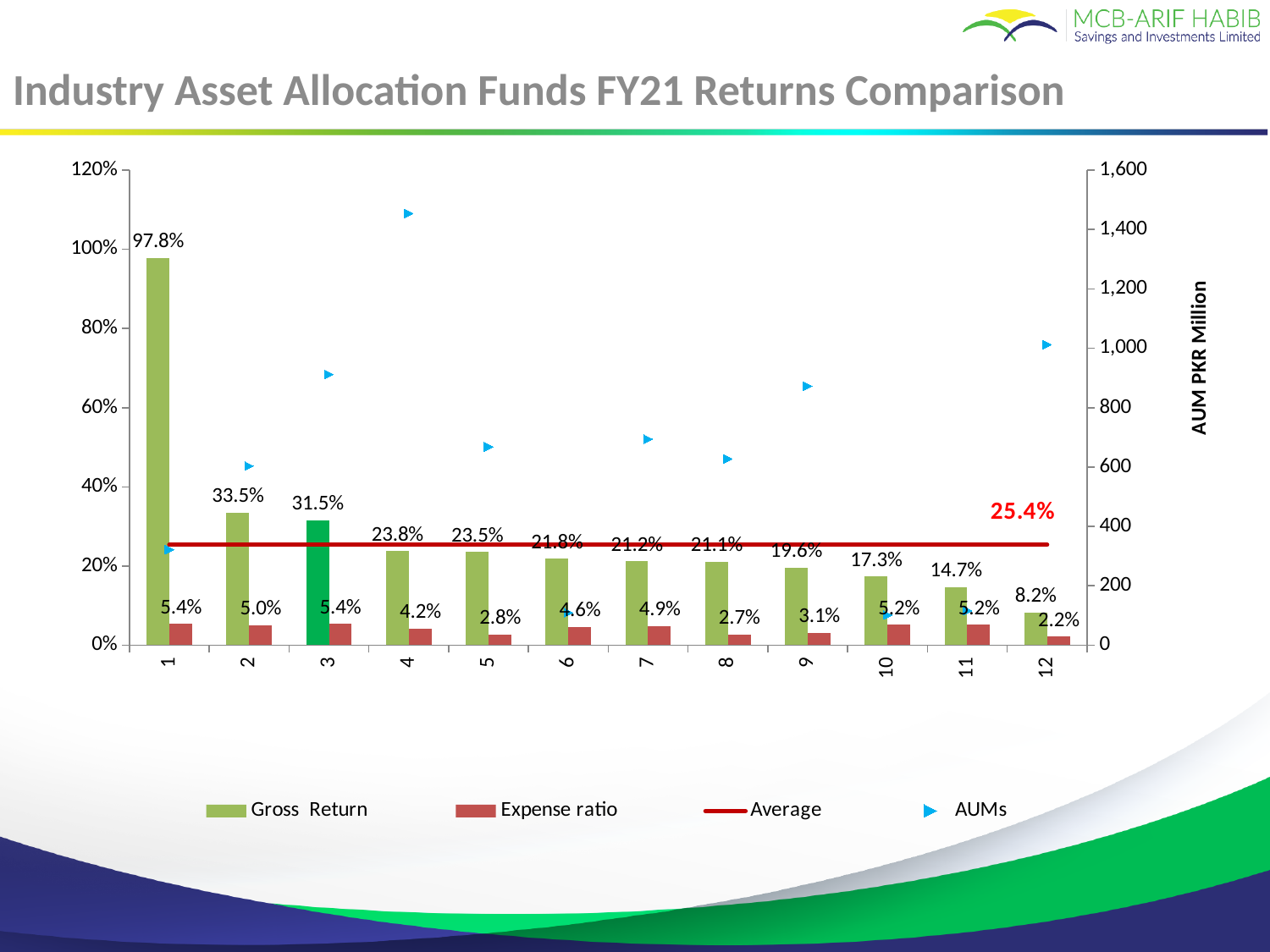
Is the AUM value for fund 4 greater or less than 1,200? greater How many series does the legend list? 4 What is the Expense ratio for fund 5? 2.8% What is the difference between the Gross Return of fund 2 and fund 3? 2.0% Which fund has the lowest Gross Return? 12 What is the Gross Return for fund 1? 97.8% How many funds are shown on the x axis? 12 What is the title of the secondary (right-hand) axis? AUM PKR Million Which fund has the lowest Expense ratio? 12 Which fund has the larger Expense ratio, fund 4 or fund 6? 6 What value is shown for the Average line? 25.4% Which fund has the highest Gross Return? 1